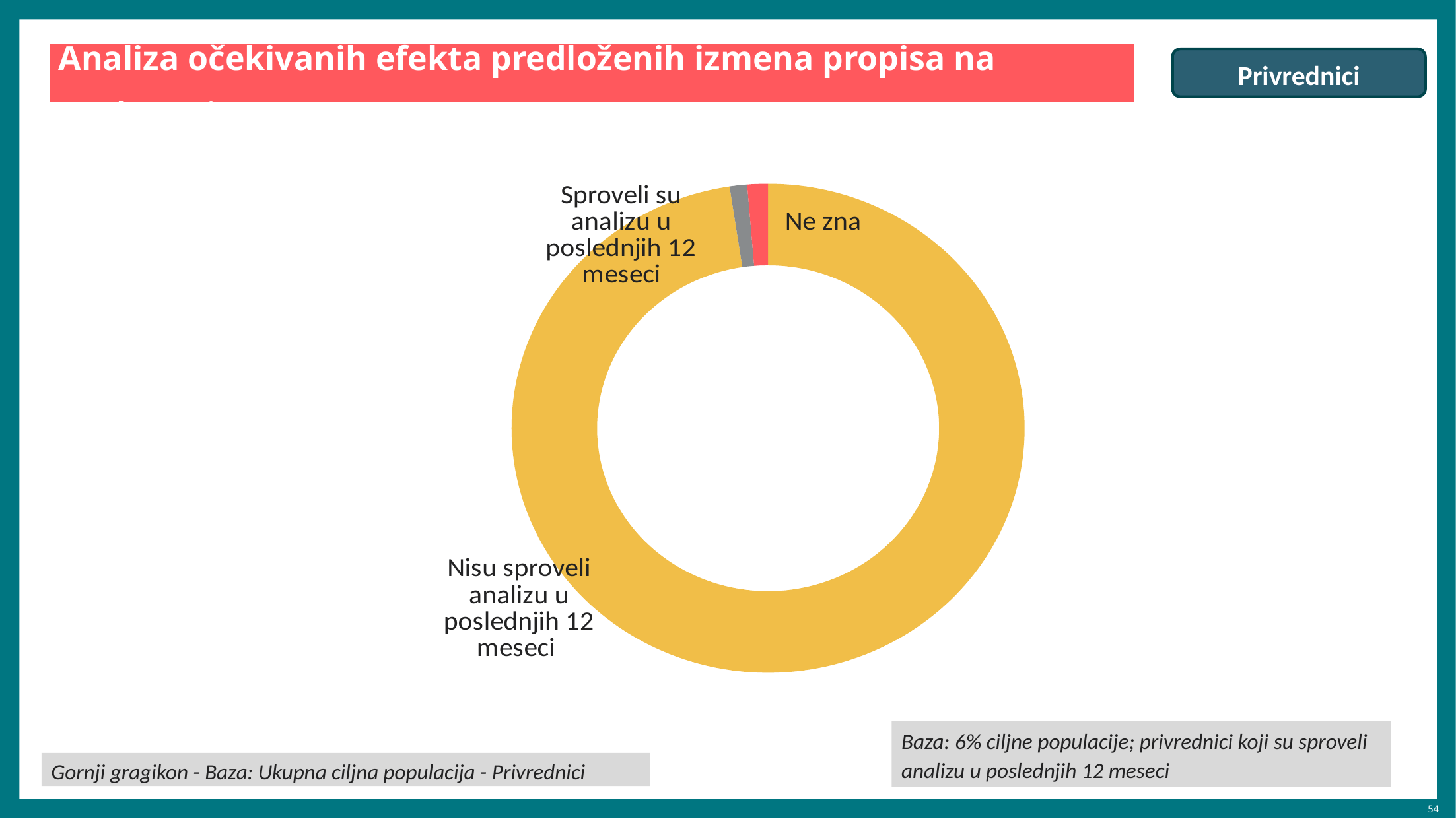
Is the share for 'Sproveli su analizu u poslednjih 12 meseci' greater or less than 25%? less What colour is the largest slice of the chart? Yellow What colour is the slice for 'Ne zna'? Red Which is larger: the slice for 'Nisu sproveli analizu u poslednjih 12 meseci' or the slice for 'Ne zna'? Nisu sproveli analizu u poslednjih 12 meseci Is the share for 'Ne zna' greater or less than 25%? less What kind of chart is shown on the slide? Doughnut (pie) chart Is the share for 'Nisu sproveli analizu u poslednjih 12 meseci' greater or less than 50%? greater Which category has the largest share of the chart? Nisu sproveli analizu u poslednjih 12 meseci How many categories (slices) does the chart have? 3 Which is larger: the slice for 'Sproveli su analizu u poslednjih 12 meseci' or the slice for 'Nisu sproveli analizu u poslednjih 12 meseci'? Nisu sproveli analizu u poslednjih 12 meseci